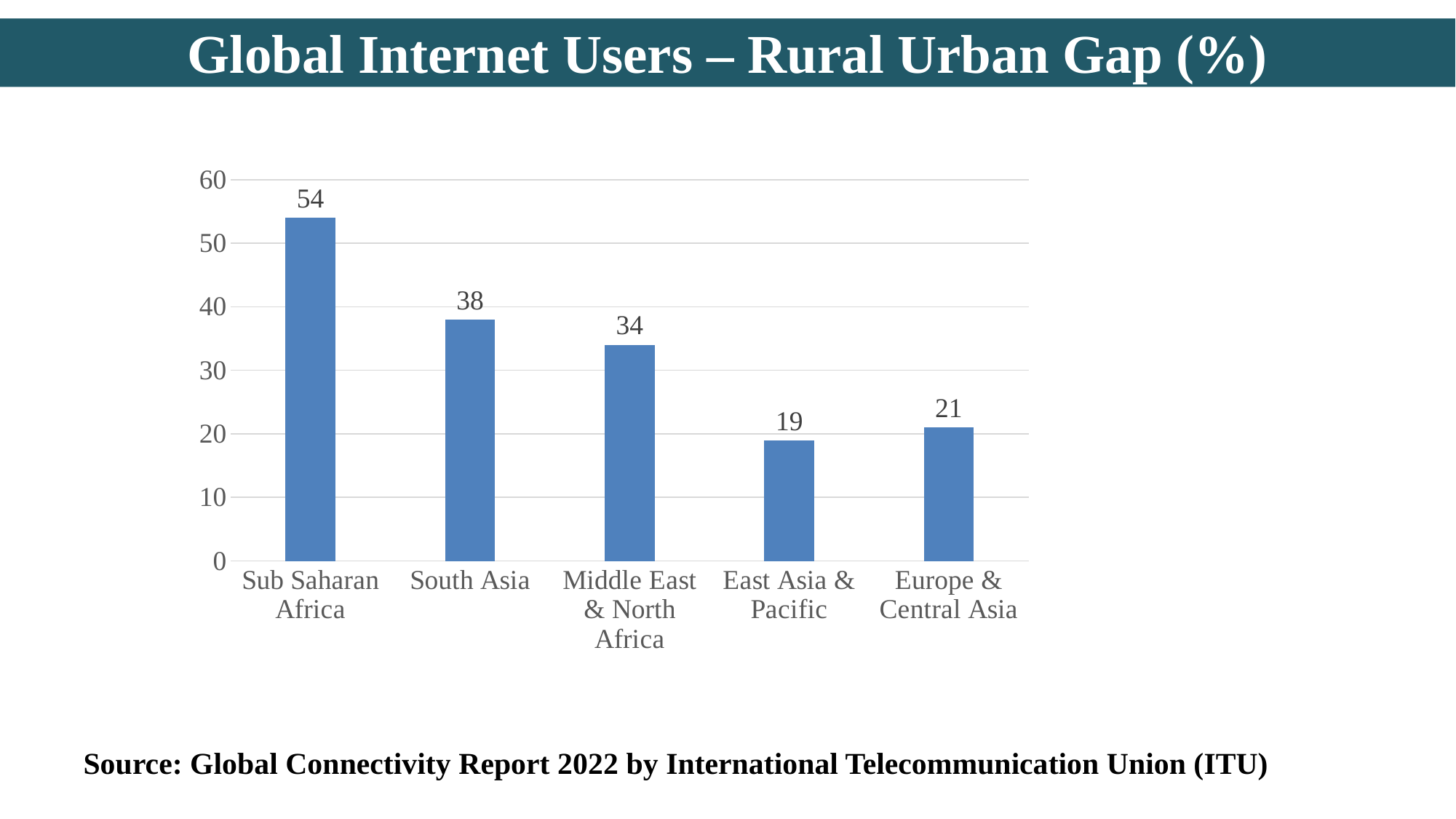
What is the value shown for East Asia & Pacific? 19 What is the value shown for South Asia? 38 What is the title of the chart? Global Internet Users – Rural Urban Gap (%) What is the difference between the values for Sub Saharan Africa and South Asia? 16 What is the value shown for Europe & Central Asia? 21 Which region has the highest rural-urban gap? Sub Saharan Africa What type of chart is shown on the slide? Bar chart What is the value shown for Middle East & North Africa? 34 Which region has the lowest rural-urban gap? East Asia & Pacific What is the rural-urban gap value for Sub Saharan Africa? 54 Which has a larger value, Europe & Central Asia or East Asia & Pacific? Europe & Central Asia How many regions are shown in the chart? 5